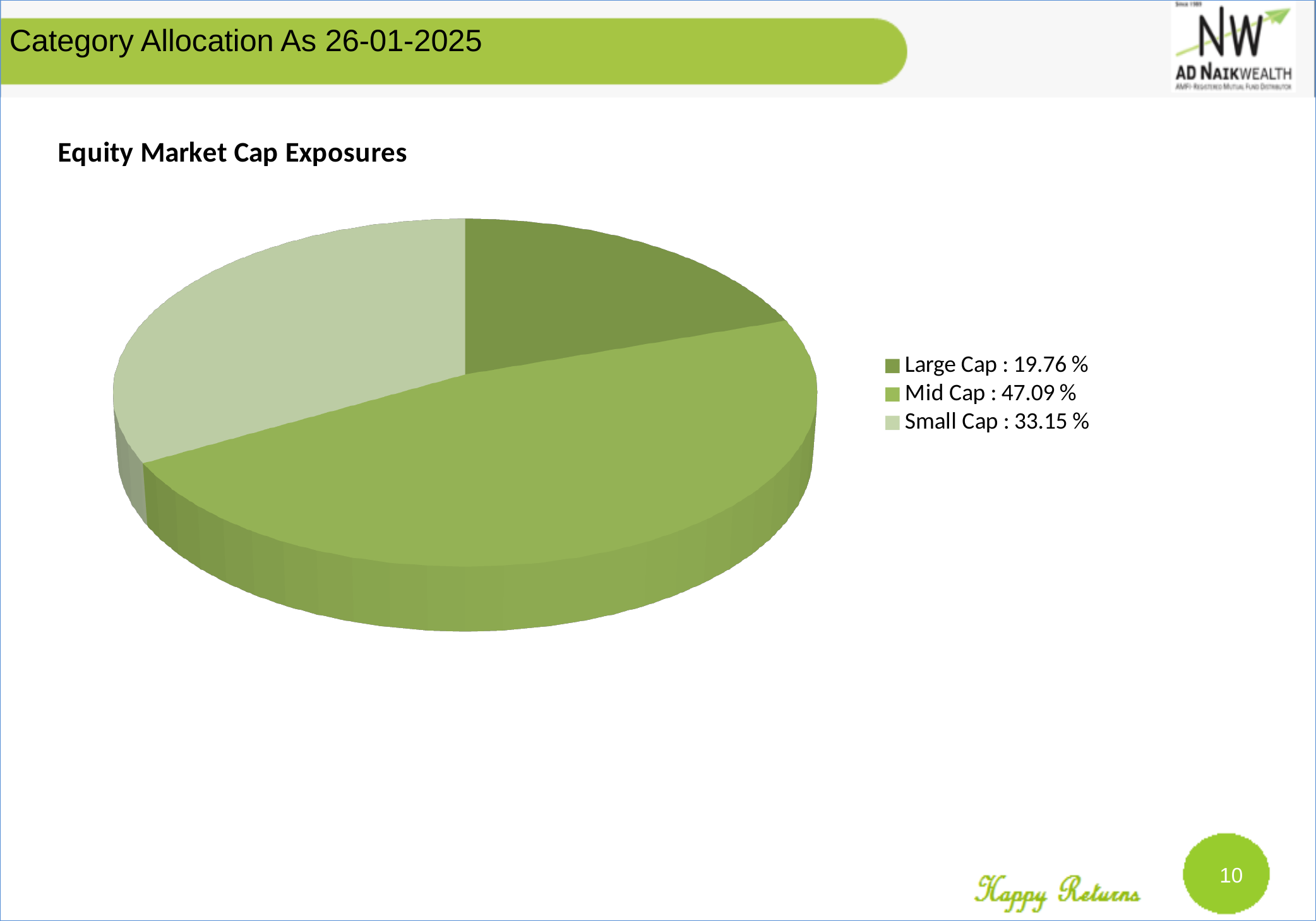
What is the difference between the Small Cap and Large Cap shares? 13.39 % Which category has the largest share of the pie? Mid Cap What is the share for Large Cap? 19.76 % How many categories are shown in the pie chart? 3 What is the share for Small Cap? 33.15 % What is the difference between the Mid Cap and Small Cap shares? 13.94 % What is the title of the chart? Equity Market Cap Exposures Which category has the smallest share of the pie? Large Cap Which category is shown in the lightest green colour? Small Cap What is the share for Mid Cap? 47.09 % Which is larger, the Small Cap share or the Large Cap share? Small Cap What type of chart is shown on the slide? Pie chart